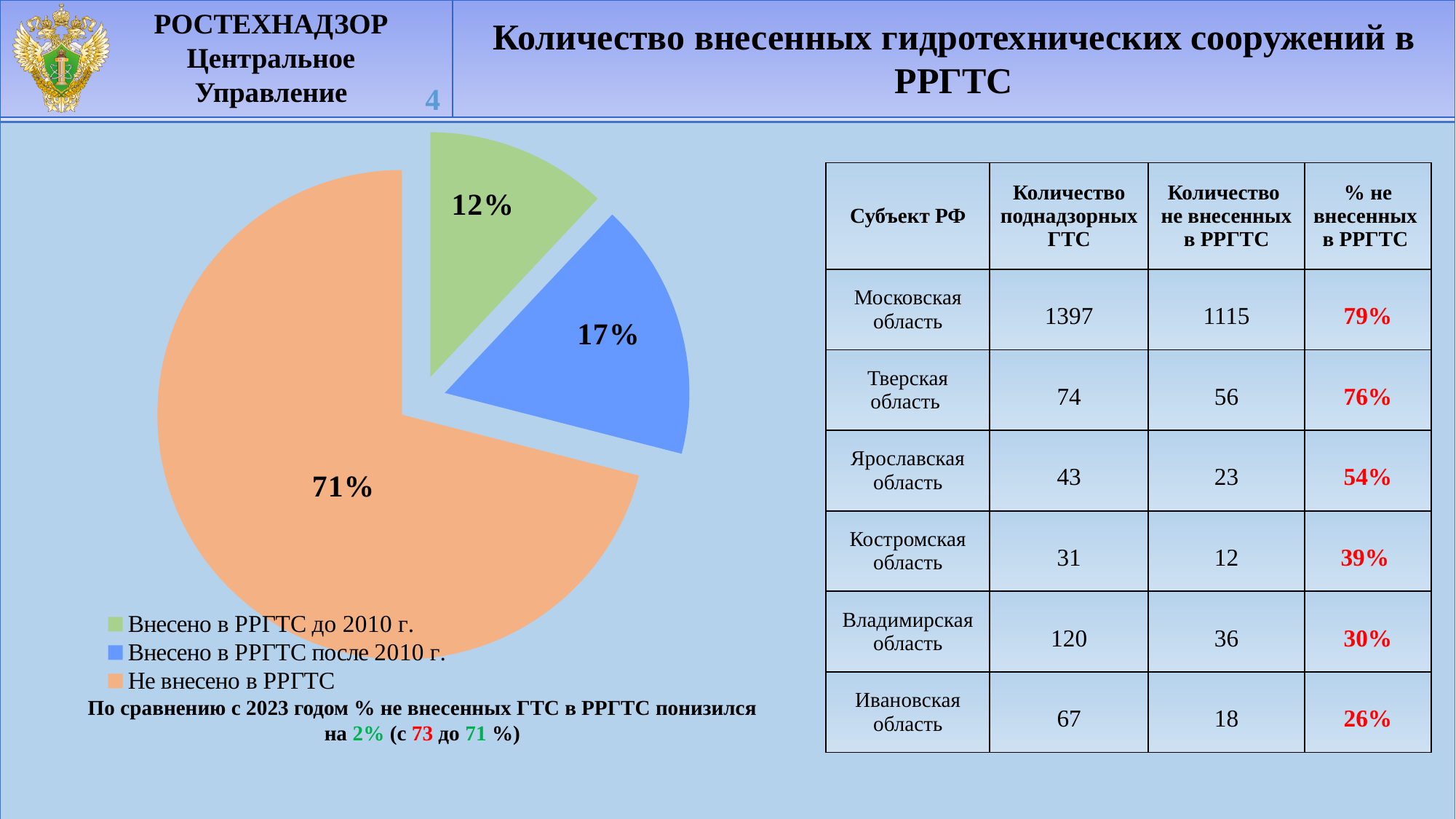
How many entries does the legend of the pie chart list? 3 Which slice of the pie chart is the smallest? Внесено в РРГТС до 2010 г. What kind of chart is shown on the slide? pie chart Which slice of the pie chart is the largest? Не внесено в РРГТС Which is larger: the share for "Внесено в РРГТС после 2010 г." or the share for "Внесено в РРГТС до 2010 г."? Внесено в РРГТС после 2010 г. What share of the pie does "Не внесено в РРГТС" have? 71% What colour is the slice for "Внесено в РРГТС после 2010 г." in the pie chart? blue What share of the pie does "Внесено в РРГТС после 2010 г." have? 17% How many slices does the pie chart have? 3 What is the difference in percentage points between "Не внесено в РРГТС" and "Внесено в РРГТС после 2010 г."? 54 What share of the pie does "Внесено в РРГТС до 2010 г." have? 12% What colour is the slice for "Не внесено в РРГТС" in the pie chart? orange